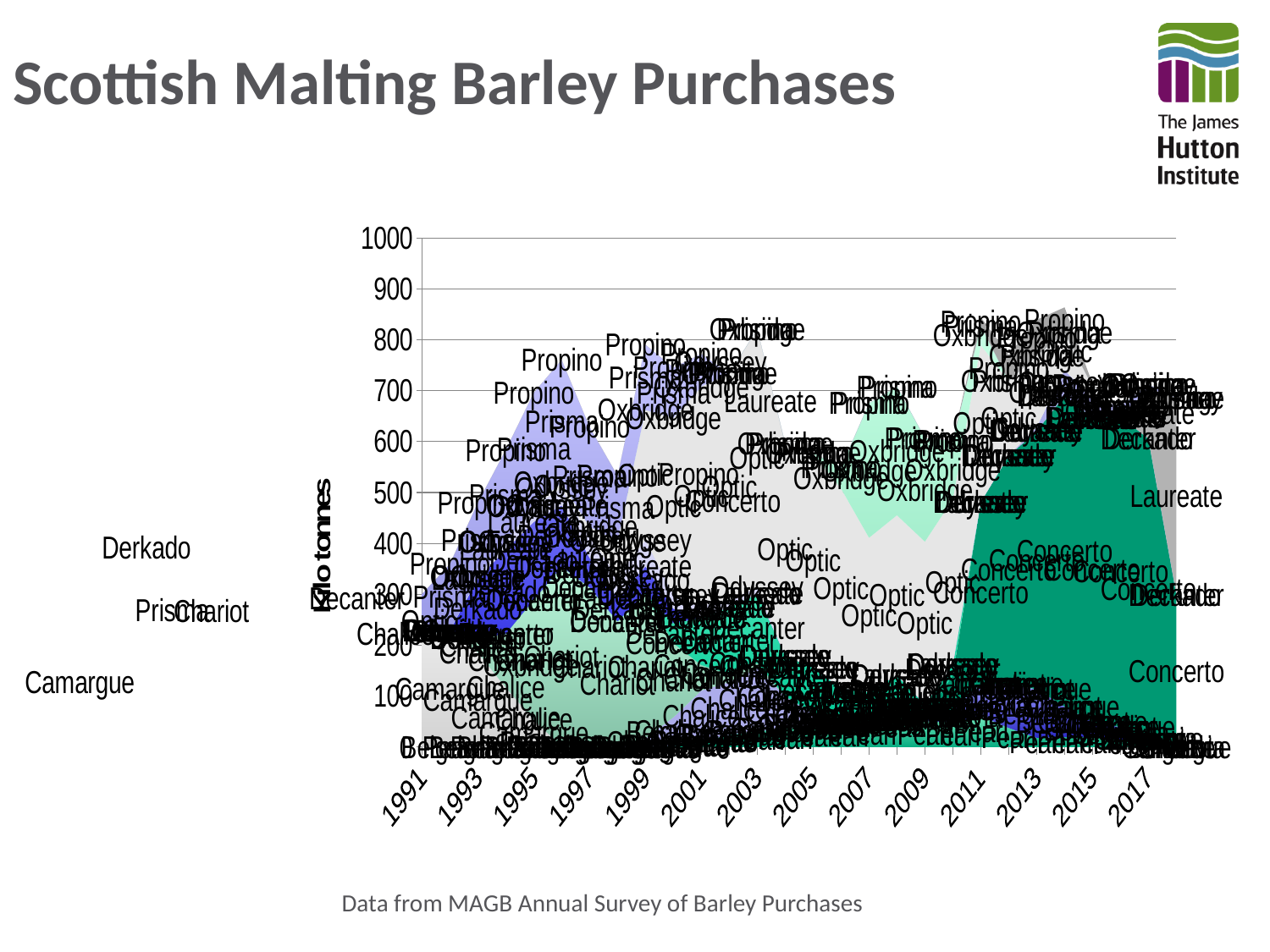
What is the title of the chart on the slide? Scottish Malting Barley Purchases What is the source of the data stated below the chart? MAGB Annual Survey of Barley Purchases What is the first year labelled on the horizontal axis of the chart? 1991 What is the highest value shown on the vertical axis of the chart? 1000 What is the interval between consecutive year labels on the horizontal axis? 2 years What kind of chart is shown on the slide? area chart How many year labels are shown along the horizontal axis of the chart? 14 What is the last year labelled on the horizontal axis of the chart? 2017